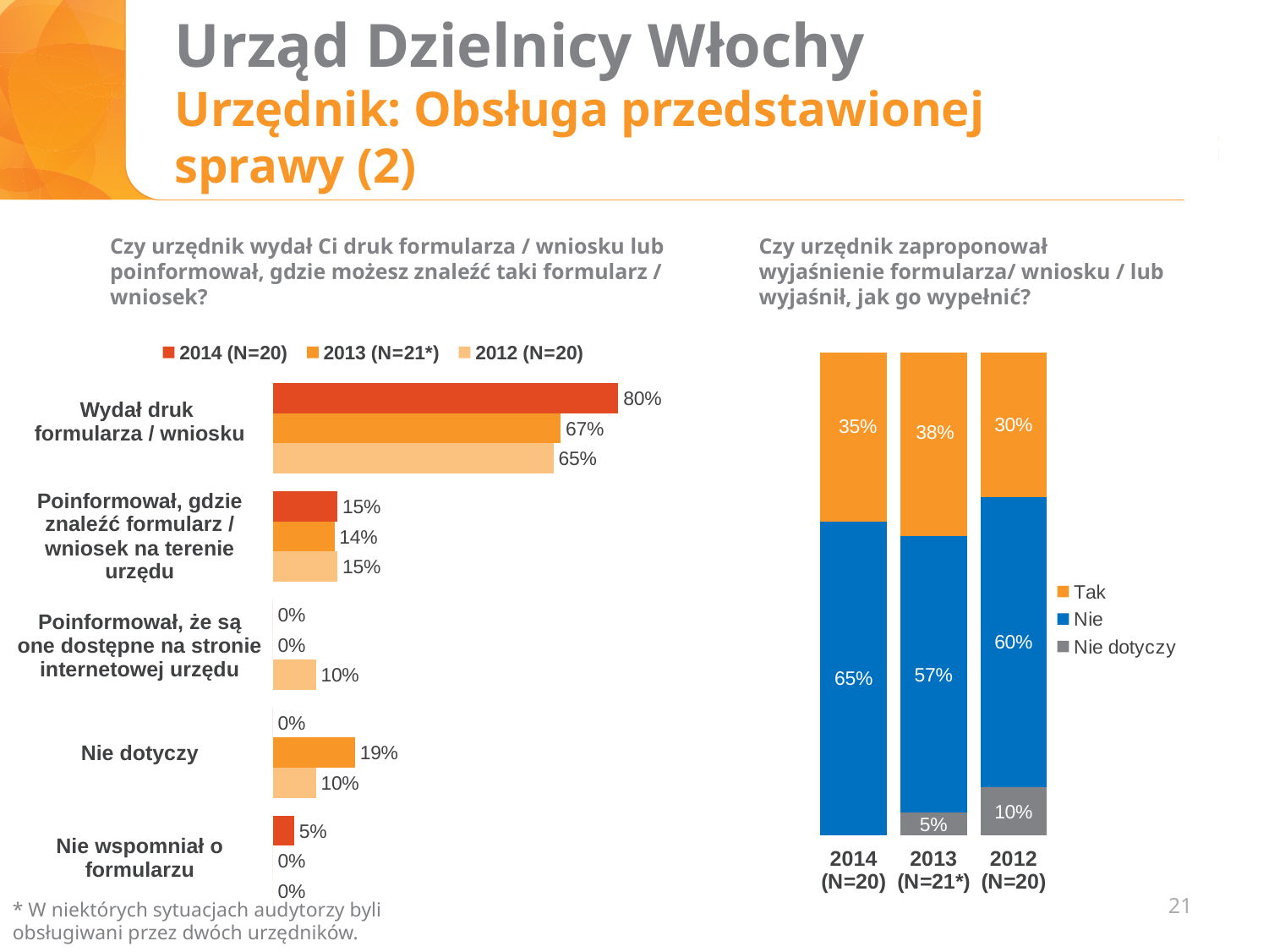
In the left chart, what is the difference between the 2014 and 2012 values for 'Wydał druk formularza / wniosku'? 15% In the left chart, which category has the highest value for 2014 (N=20)? Wydał druk formularza / wniosku In the left chart, what is the 2014 (N=20) value for 'Wydał druk formularza / wniosku'? 80% In the left chart, how many series does the legend list? 3 In the left chart, how many categories are shown? 5 In the right chart, which year has the highest 'Tak' value? 2013 (N=21*) In the right chart, what is the total of the 2013 (N=21*) stacked bar? 100% In the right chart, what is the 'Nie dotyczy' value for 2012 (N=20)? 10% What type of chart is the left chart? Bar chart In the right chart, what is the 'Nie' value for 2013 (N=21*)? 57% In the left chart, what is the 2012 (N=20) value for 'Poinformował, że są one dostępne na stronie internetowej urzędu'? 10% In the left chart, what is the 2013 (N=21*) value for 'Nie dotyczy'? 19%